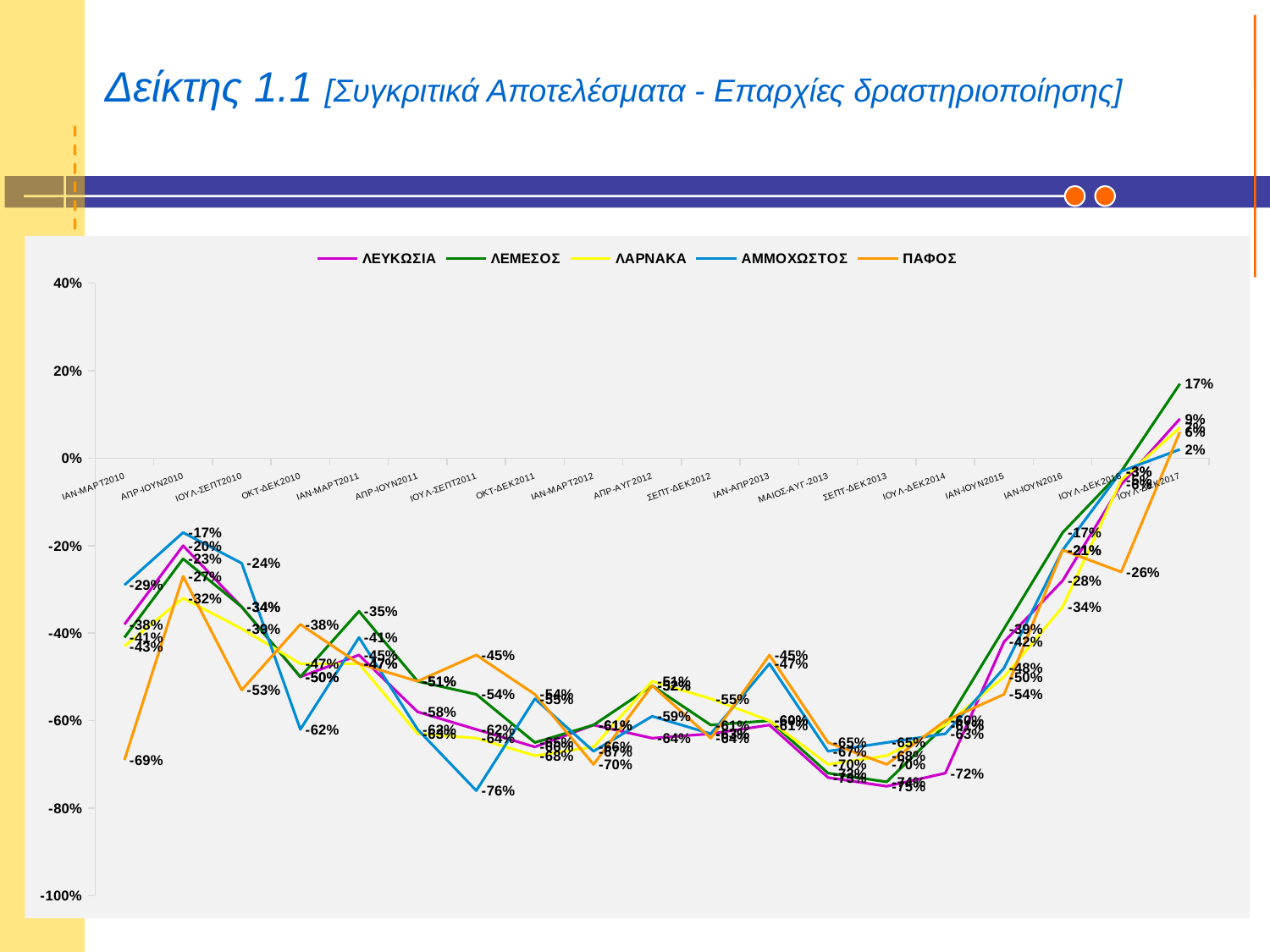
What is the value for ΑΜΜΟΧΩΣΤΟΣ at ΟΚΤ-ΔΕΚ2011? -55% What is the difference between ΛΕΜΕΣΟΣ and ΠΑΦΟΣ at ΙΟΥΛ-ΔΕΚ2017? 11 percentage points Does the ΛΕΜΕΣΟΣ line rise or fall from ΙΟΥΛ-ΔΕΚ2014 to ΙΟΥΛ-ΔΕΚ2017? rise What is the value for ΠΑΦΟΣ at ΙΟΥΛ-ΔΕΚ2016? -26% What is the value for ΠΑΦΟΣ at ΙΑΝ-ΜΑΡΤ2010? -69% What kind of chart is shown on the slide? line chart Which is larger at ΙΟΥΛ-ΣΕΠΤ2010, the value for ΑΜΜΟΧΩΣΤΟΣ or the value for ΠΑΦΟΣ? ΑΜΜΟΧΩΣΤΟΣ Which series has the lowest value at ΙΑΝ-ΜΑΡΤ2010? ΠΑΦΟΣ What is the value for ΛΕΜΕΣΟΣ at ΙΟΥΛ-ΔΕΚ2017? 17% How many series does the legend list? 5 How many time periods are shown along the x axis? 19 Which series has the highest value at ΙΟΥΛ-ΔΕΚ2017? ΛΕΜΕΣΟΣ